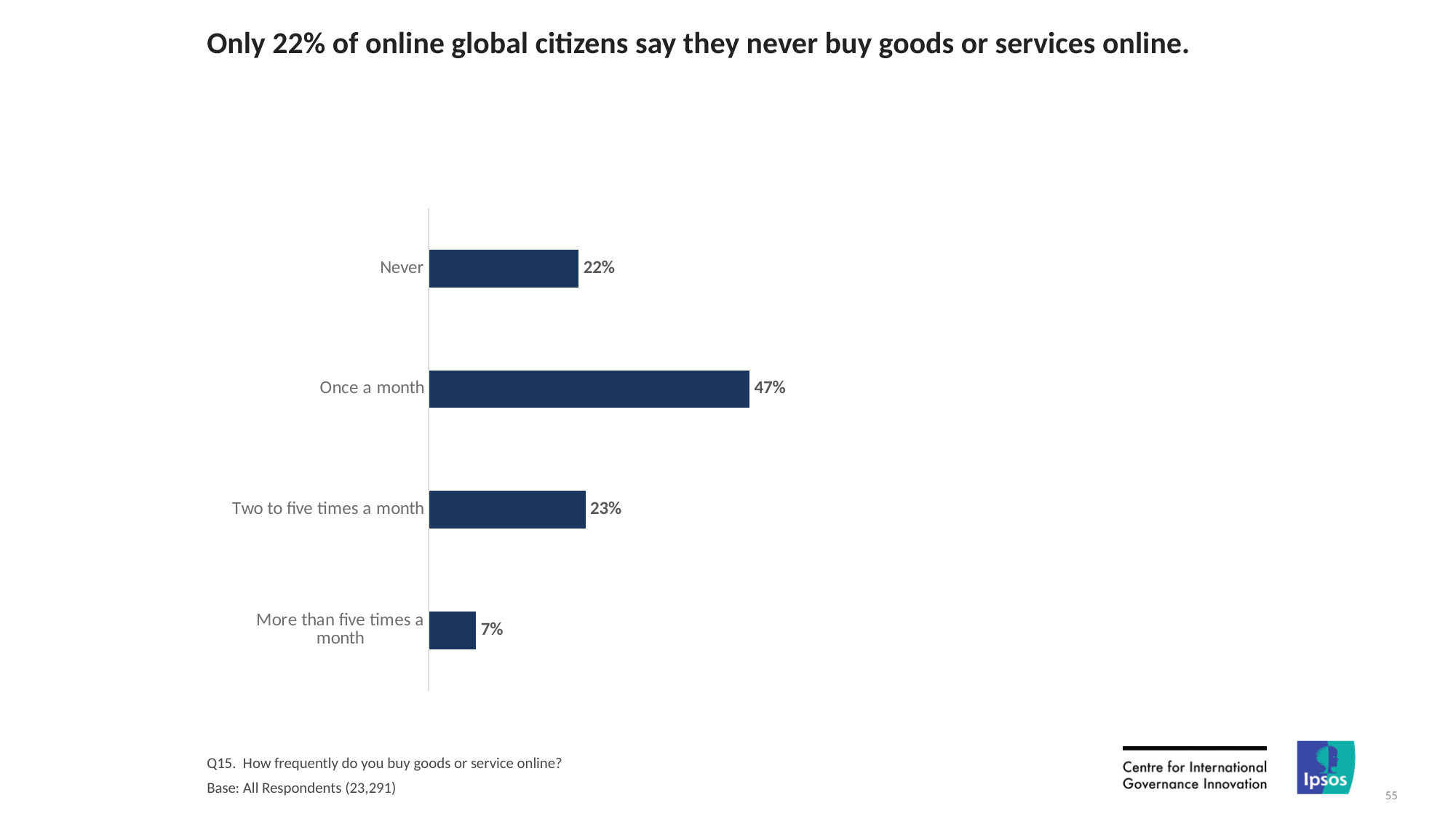
What is the value for 'More than five times a month'? 7% What kind of chart is shown on the slide? Bar chart What is the difference between the 'Once a month' value and the 'Never' value? 25% What percentage of respondents say they buy goods or services online once a month? 47% Which category has the highest value? Once a month How many categories are shown in the chart? 4 Which category has the lowest value? More than five times a month What percentage of respondents say they never buy goods or services online? 22% What is the value for 'Two to five times a month'? 23% What is the difference between 'Two to five times a month' and 'More than five times a month'? 16% Which is larger, the value for 'Once a month' or the value for 'Two to five times a month'? Once a month What is the base (number of respondents) stated on the slide? All Respondents (23,291)